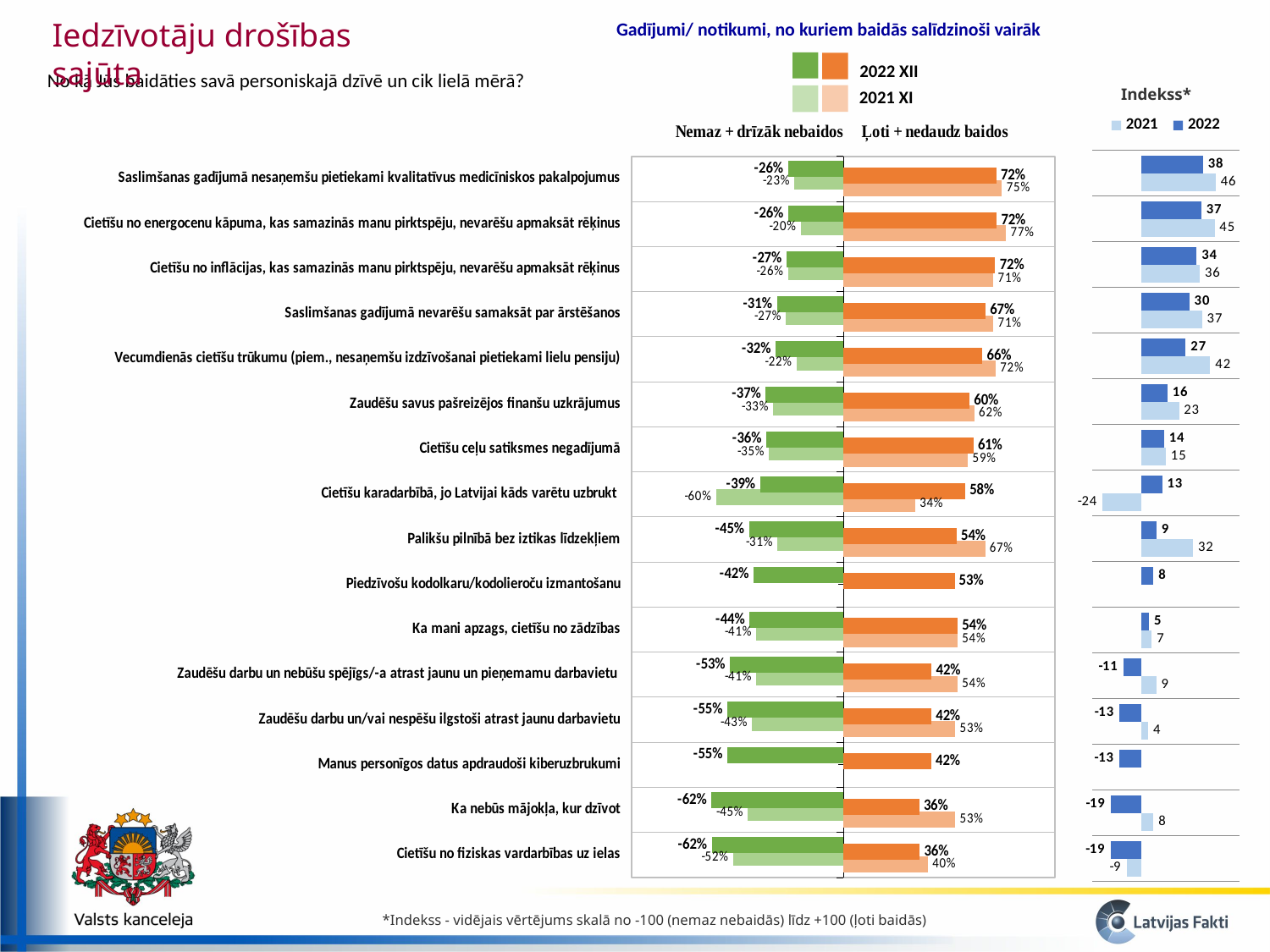
How many categories are shown in the chart titled "Gadījumi/ notikumi, no kuriem baidās salīdzinoši vairāk"? 16 In the chart titled "Gadījumi/ notikumi, no kuriem baidās salīdzinoši vairāk", what is the 2022 XII "Ļoti + nedaudz baidos" value for "Cietīšu ceļu satiksmes negadījumā"? 61% How many series does the legend of the chart titled "Gadījumi/ notikumi, no kuriem baidās salīdzinoši vairāk" list? 2 In the "Indekss*" chart on the right, which category has the lowest 2021 index? Cietīšu karadarbībā, jo Latvijai kāds varētu uzbrukt In the chart titled "Gadījumi/ notikumi, no kuriem baidās salīdzinoši vairāk", what is the 2021 XI "Ļoti + nedaudz baidos" value for "Ka nebūs mājokļa, kur dzīvot"? 53% In the "Indekss*" chart on the right, what is the difference between the 2021 and 2022 index for "Vecumdienās cietīšu trūkumu (piem., nesaņemšu izdzīvošanai pietiekami lielu pensiju)"? 15 In the "Indekss*" chart on the right, what is the 2022 index for "Zaudēšu savus pašreizējos finanšu uzkrājumus"? 16 In the chart titled "Gadījumi/ notikumi, no kuriem baidās salīdzinoši vairāk", for "Cietīšu karadarbībā, jo Latvijai kāds varētu uzbrukt", which is larger: the 2022 XII or the 2021 XI "Ļoti + nedaudz baidos" value? 2022 XII What kind of chart is the "Indekss*" chart on the right of the slide? Bar chart In the "Indekss*" chart on the right, which category has the highest 2022 index? Saslimšanas gadījumā nesaņemšu pietiekami kvalitatīvus medicīniskos pakalpojumus In the "Indekss*" chart on the right, what is the 2021 index for "Palikšu pilnībā bez iztikas līdzekļiem"? 32 In the chart titled "Gadījumi/ notikumi, no kuriem baidās salīdzinoši vairāk", what is the 2021 XI "Nemaz + drīzāk nebaidos" value for "Cietīšu karadarbībā, jo Latvijai kāds varētu uzbrukt"? -60%